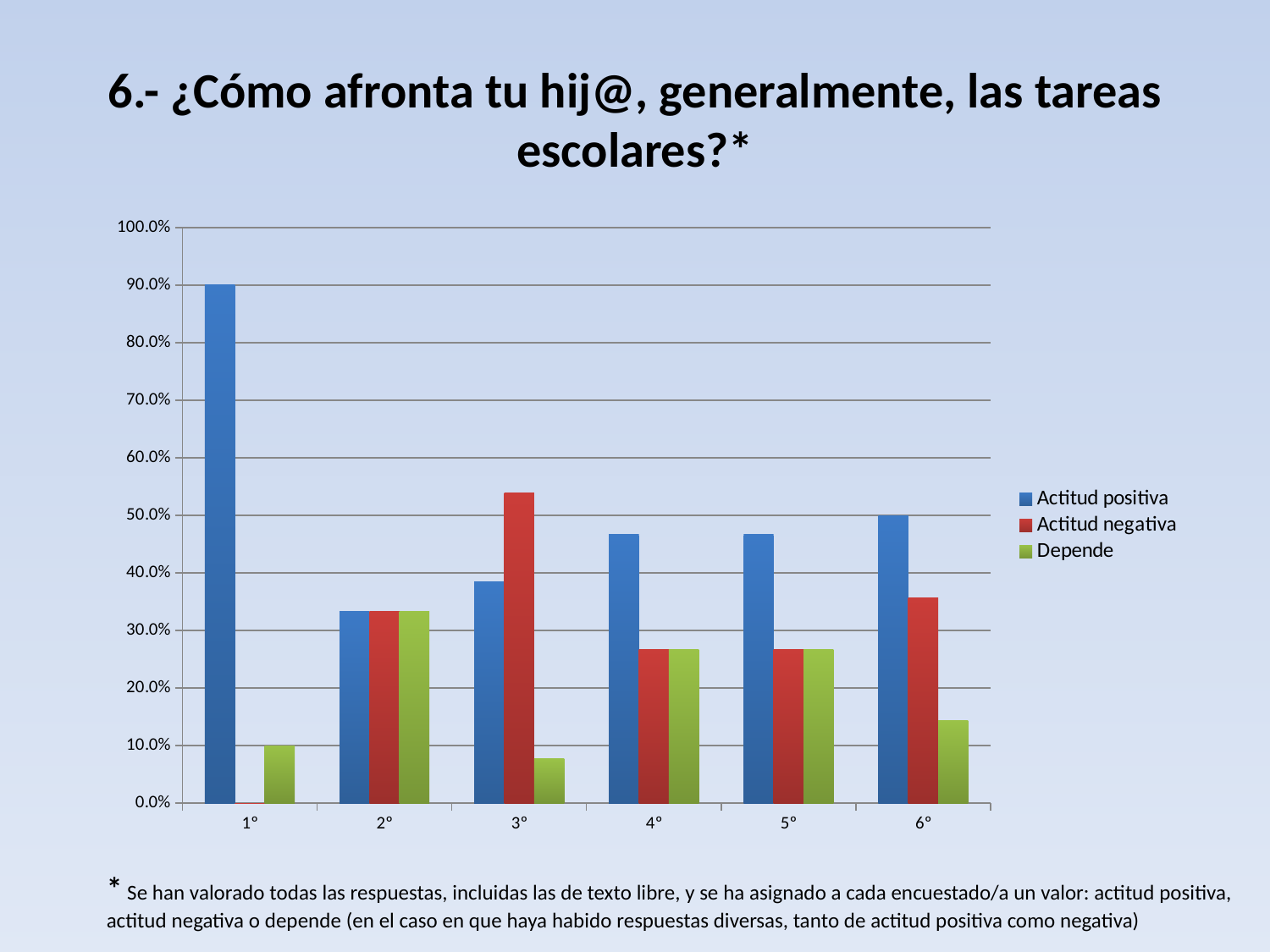
What are the three entries listed in the legend? Actitud positiva, Actitud negativa, Depende How many grade categories are shown on the x axis? 6 Which grade has the highest value for Actitud negativa? 3° In 3°, which is larger: Actitud positiva or Actitud negativa? Actitud negativa Which grade has the lowest value for Actitud positiva? 2° How many series does the legend list? 3 Is the value for Actitud positiva in 4° greater or less than 40.0%? greater Which grade has the highest value for Actitud positiva? 1° Is the value for Actitud negativa in 3° greater or less than 50.0%? greater What kind of chart is shown on the slide? bar chart What is the value for Actitud positiva in 1°? 90.0% Is the value for Depende in 3° greater or less than 10.0%? less